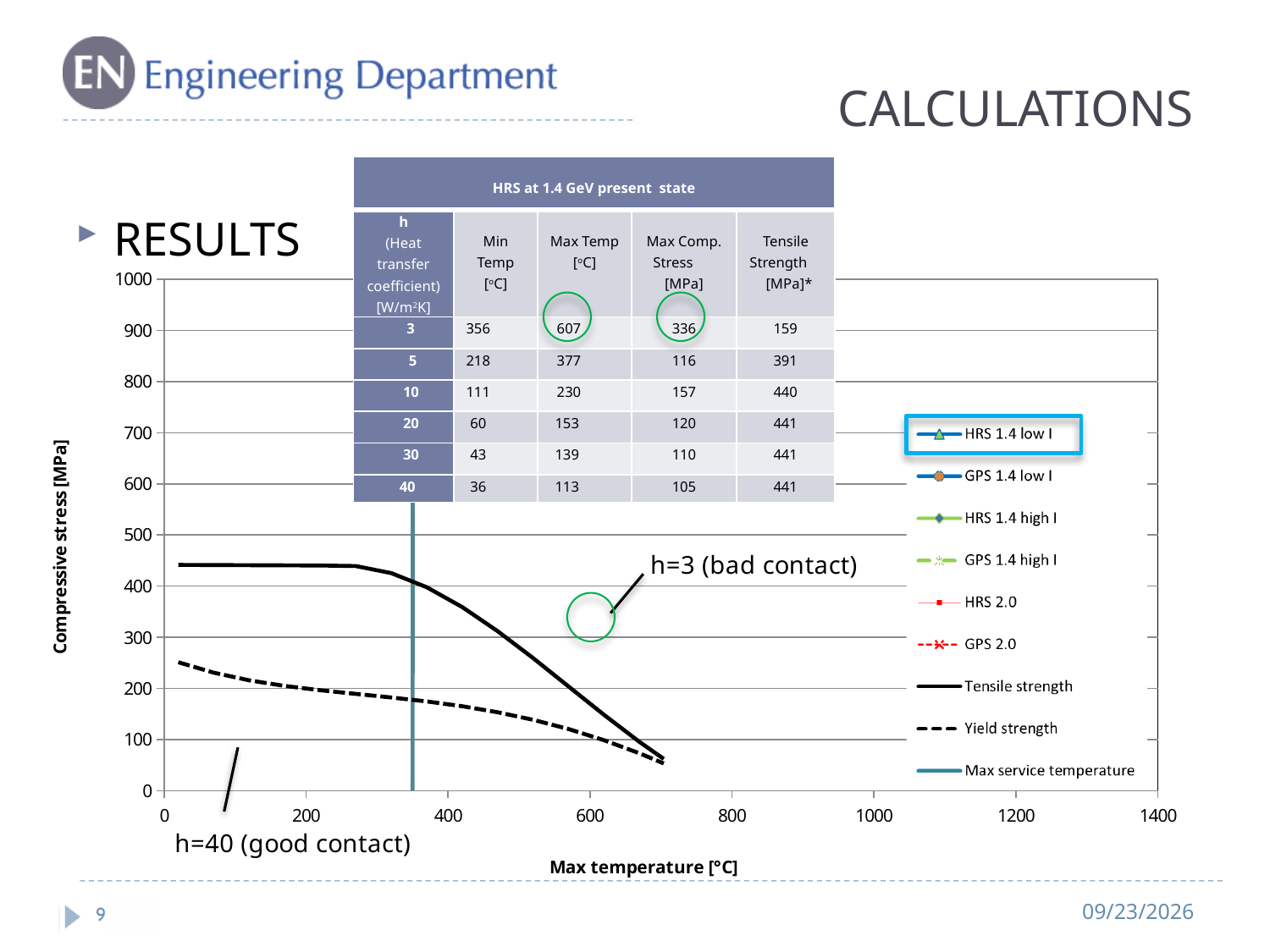
What is the title of the chart's y axis? Compressive stress [MPa] Is the Tensile strength value at 700 °C greater or less than 100 MPa? less What kind of chart is shown on the slide? line chart Is the Tensile strength value at 200 °C greater or less than 400 MPa? greater How many series does the chart legend list? 9 Does the Tensile strength curve rise or fall as Max temperature increases? fall Does the Yield strength curve rise or fall as Max temperature increases? fall At 200 °C, which is larger: Tensile strength or Yield strength? Tensile strength Is the Yield strength value at 400 °C greater or less than 200 MPa? less What is the title of the chart's x axis? Max temperature [°C]